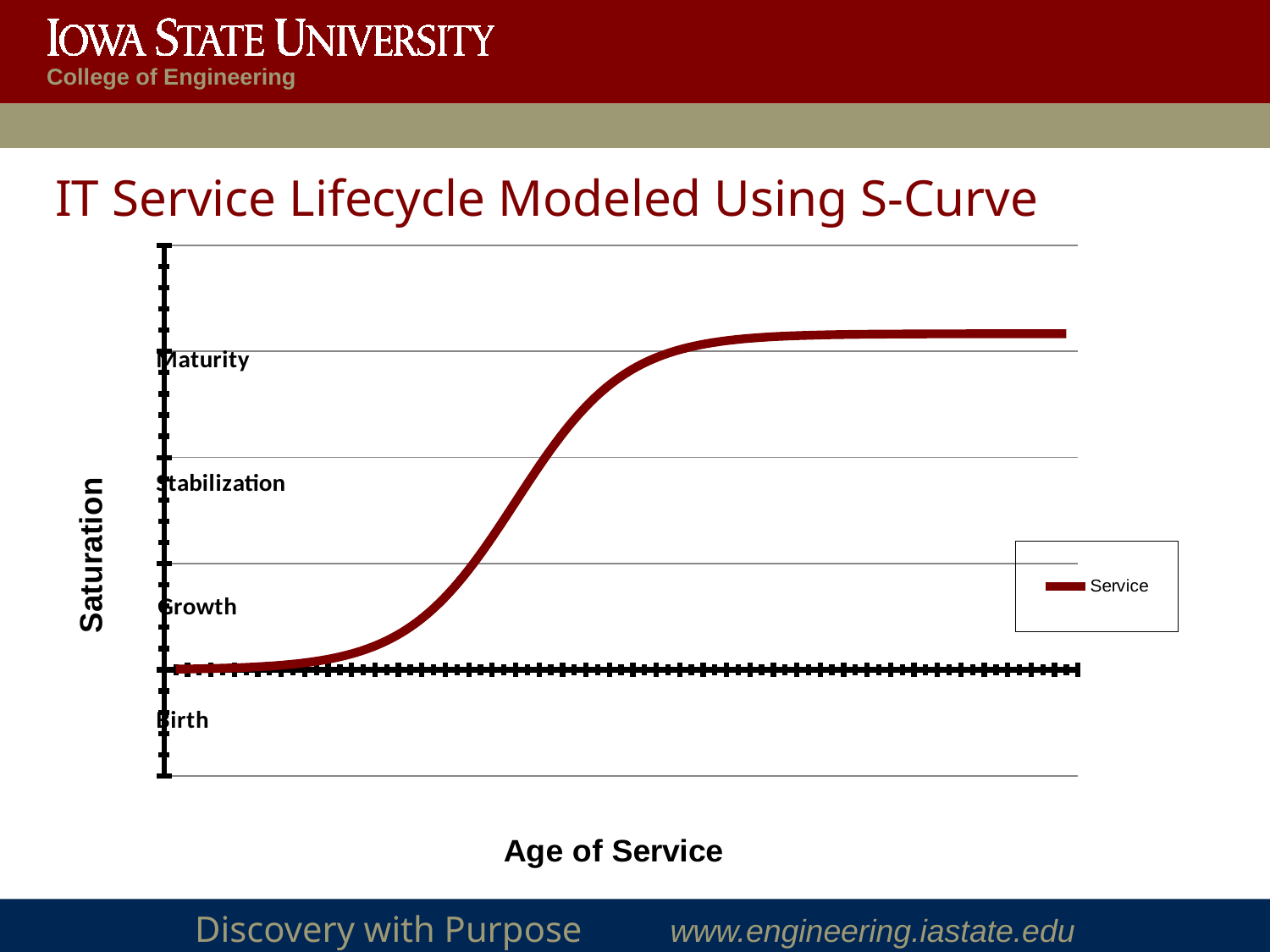
What kind of chart is shown on the slide? line chart What is the name of the series listed in the chart's legend? Service What is the title of the chart's horizontal axis? Age of Service Does the Service line flatten out at the top of the chart near the Maturity stage or near the Birth stage? Maturity Do the values of the Service line rise or fall as you move along the x axis from left to right? rise How many lifecycle stage labels are shown along the vertical axis of the chart? 4 How many series does the chart's legend list? 1